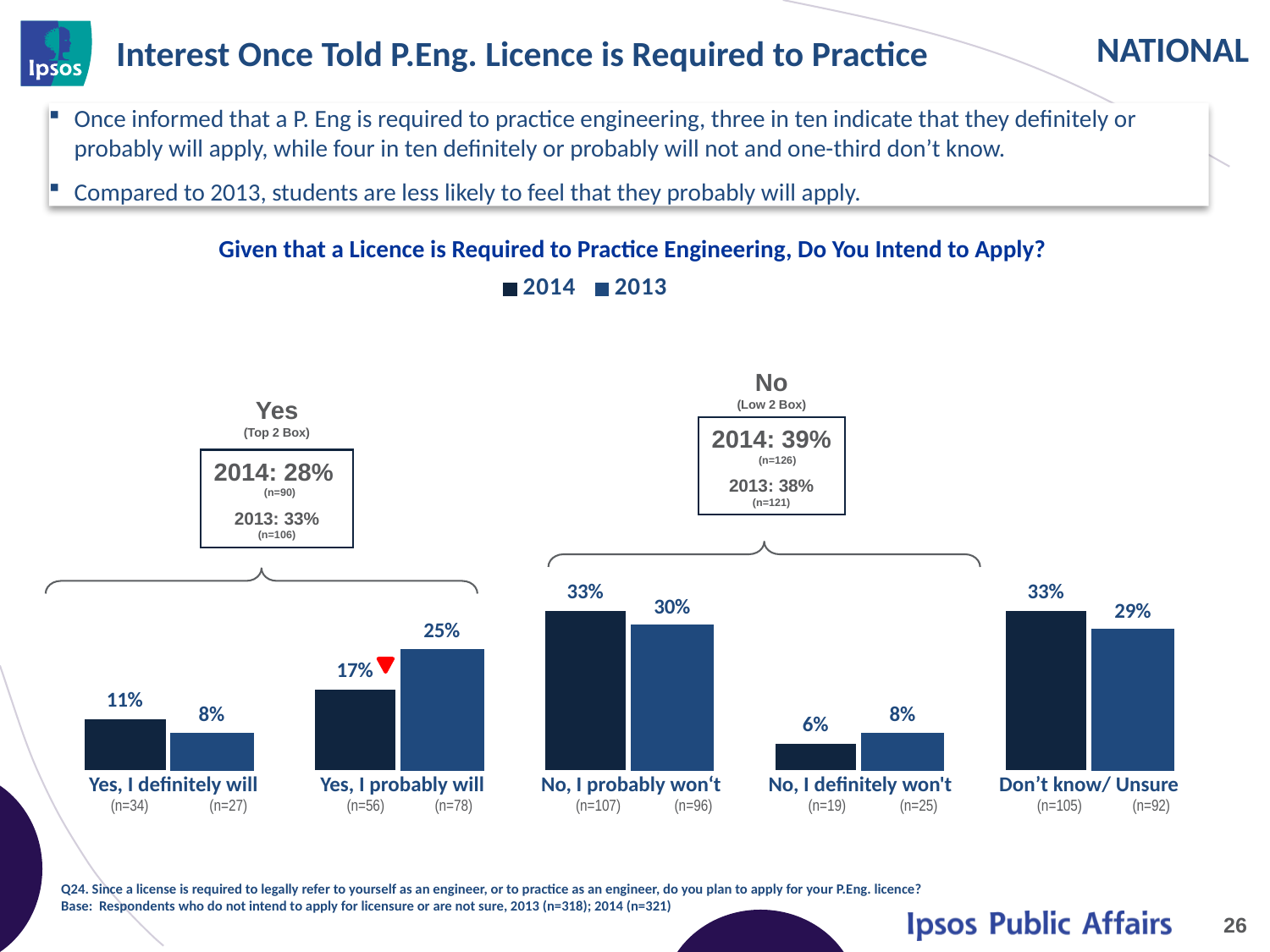
What is the difference between the 2014 and 2013 values for "Yes, I definitely will"? 3% Which is larger for "No, I probably won't": the 2014 value or the 2013 value? 2014 What kind of chart is shown on the slide? bar chart What is the 2014 value for "No, I probably won't"? 33% What is the 2013 value for "Yes, I probably will"? 25% What is the 2013 value for "Don't know/ Unsure"? 29% What is the 2014 value for "Yes, I definitely will"? 11% Which category has the lowest 2014 value? No, I definitely won't How many response categories are shown along the x axis? 5 What is the title of the chart? Given that a Licence is Required to Practice Engineering, Do You Intend to Apply? How many series does the legend list? 2 What is the difference between the 2013 and 2014 values for "Yes, I probably will"? 8%